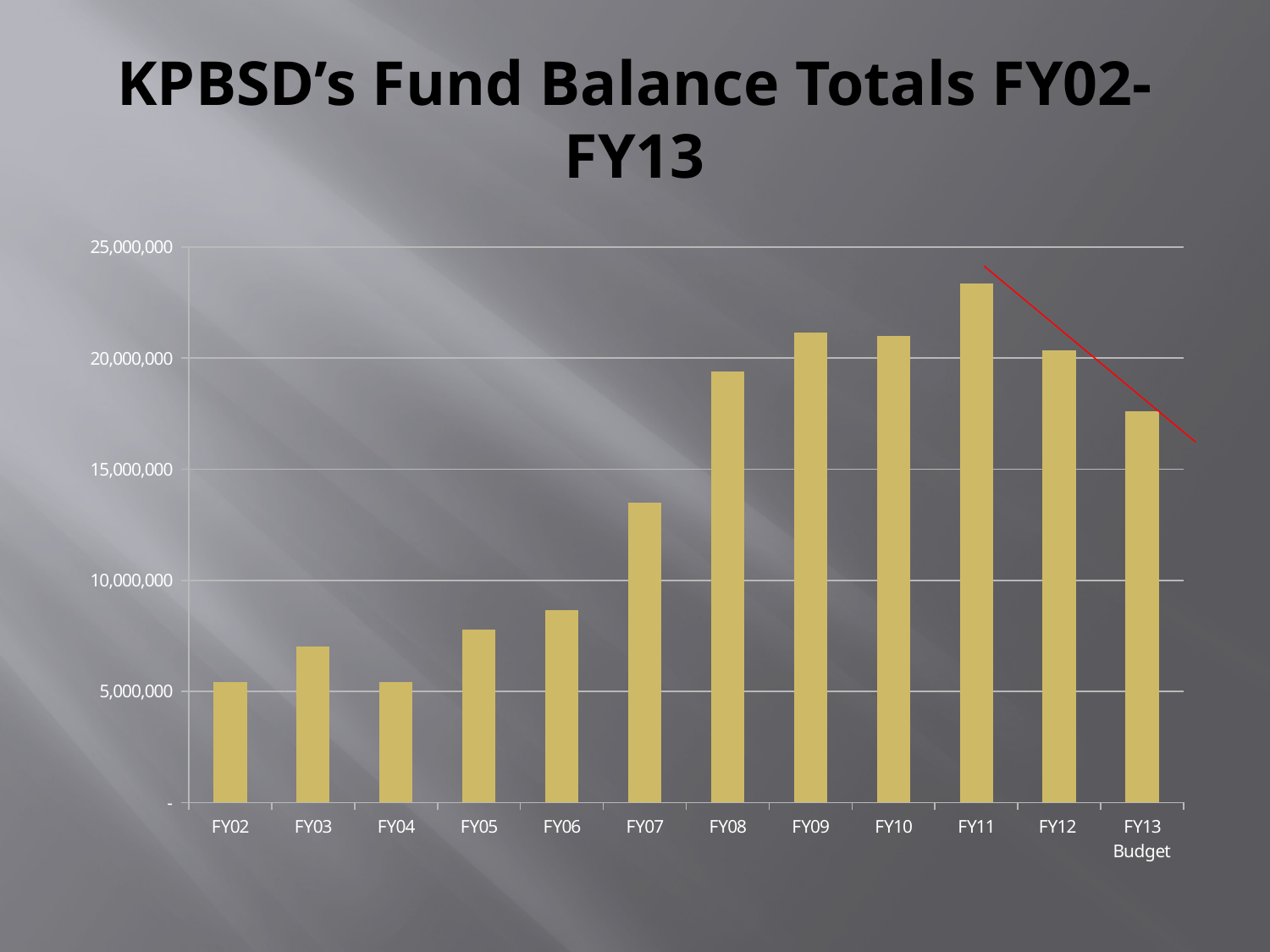
Do the values rise or fall from FY11 to FY13 Budget? Fall How many fiscal-year categories are shown on the x axis? 12 Is the value for FY08 greater or less than 20,000,000? less Which fiscal year has the highest fund balance? FY11 Which is larger, the value for FY07 or the value for FY08? FY08 What kind of chart is shown on the slide? Bar chart Is the value for FY13 Budget greater or less than 20,000,000? less What is the title of the chart? KPBSD's Fund Balance Totals FY02-FY13 Is the value for FY07 greater or less than 10,000,000? greater Which is larger, the value for FY12 or the value for FY13 Budget? FY12